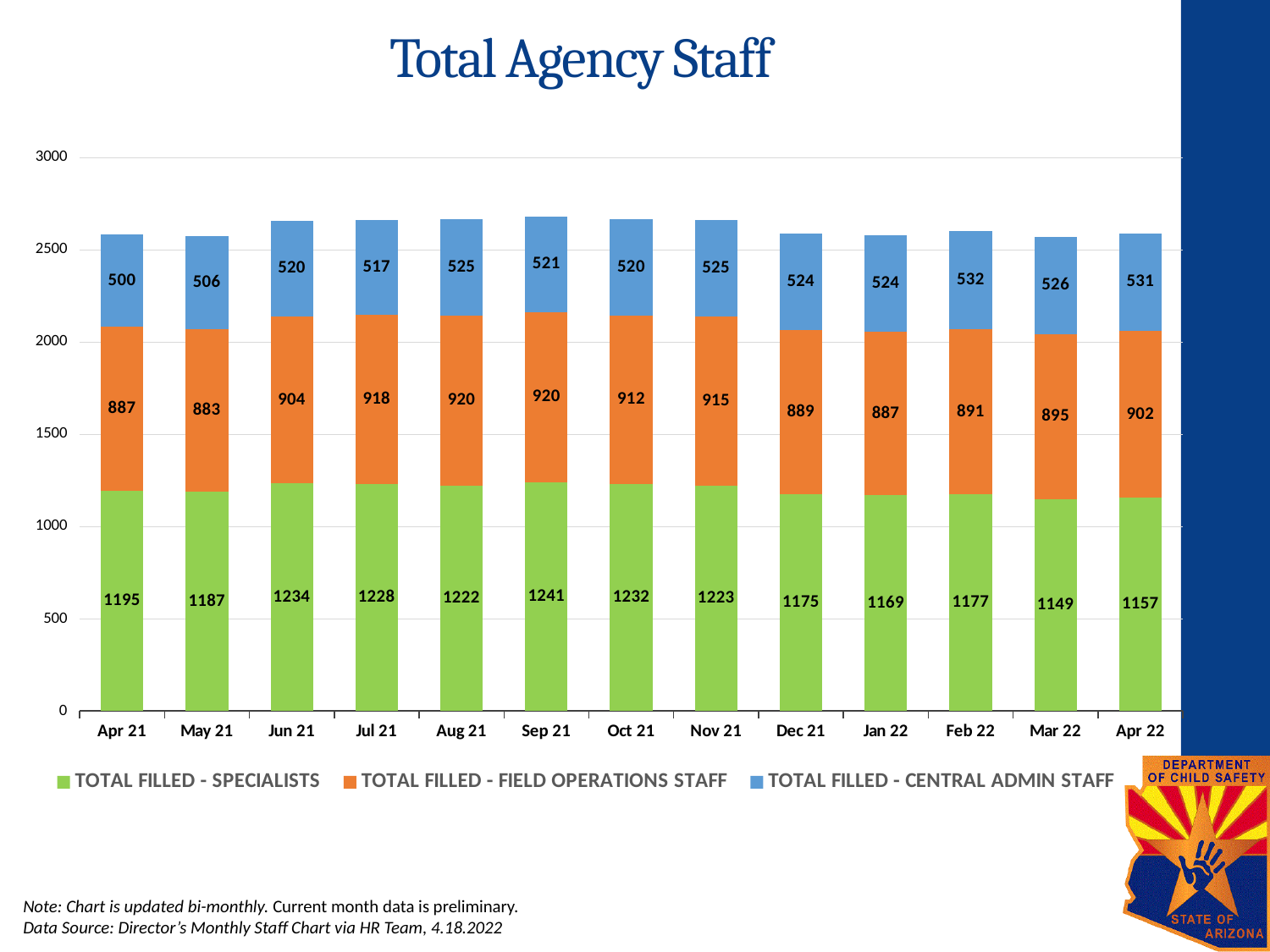
What is the value for TOTAL FILLED - CENTRAL ADMIN STAFF in Apr 22? 531 In which month is the TOTAL FILLED - CENTRAL ADMIN STAFF value lowest? Apr 21 In which month is the TOTAL FILLED - SPECIALISTS value highest? Sep 21 How many series does the legend list? 3 Which is larger, the TOTAL FILLED - FIELD OPERATIONS STAFF value for Jul 21 or for Dec 21? Jul 21 What is the value for TOTAL FILLED - FIELD OPERATIONS STAFF in Nov 21? 915 What is the value for TOTAL FILLED - SPECIALISTS in Jun 21? 1234 How many months are shown on the x axis? 13 What type of chart is shown on the slide? Stacked bar chart In which month is the TOTAL FILLED - SPECIALISTS value lowest? Mar 22 What is the total of the stacked bar for Apr 21? 2582 What is the difference between the TOTAL FILLED - SPECIALISTS values for Sep 21 and Mar 22? 92